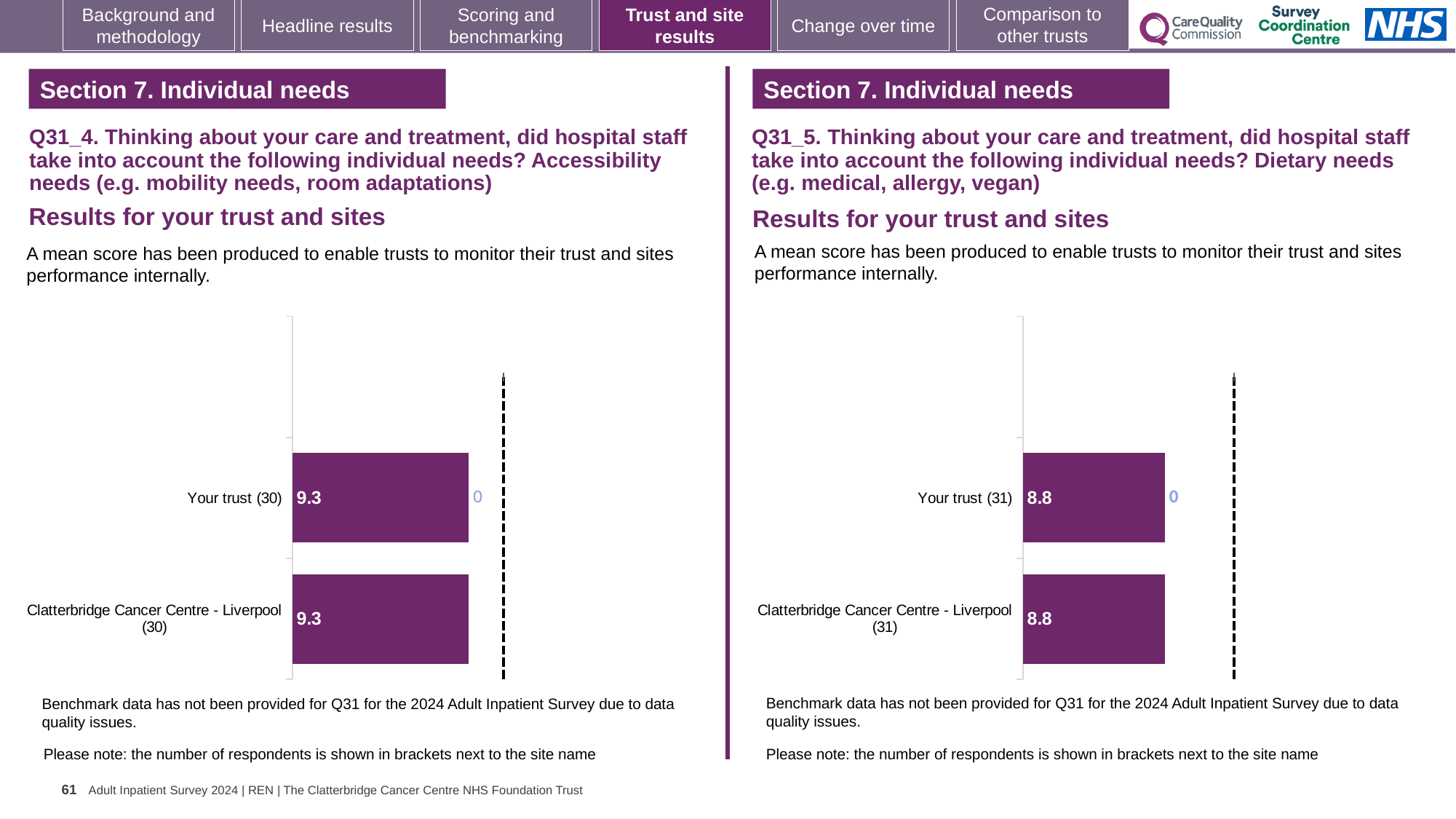
How many bars are plotted on the right chart (Q31_5)? 2 What type of chart is used on the left (Q31_4)? Bar chart How many bars are plotted on the left chart (Q31_4)? 2 On the right chart (Q31_5, Dietary needs), what is the mean score for Clatterbridge Cancer Centre - Liverpool? 8.8 On the left chart (Q31_4, Accessibility needs), what is the mean score for Your trust? 9.3 On the right chart (Q31_5), how many respondents are shown in brackets for Clatterbridge Cancer Centre - Liverpool? 31 Is the Your trust score on the left chart (Q31_4) larger or smaller than the Your trust score on the right chart (Q31_5)? Larger On the right chart (Q31_5), what is the difference between the score for Your trust and the score for Clatterbridge Cancer Centre - Liverpool? 0 On the right chart (Q31_5, Dietary needs), what is the mean score for Your trust? 8.8 On the left chart (Q31_4, Accessibility needs), what is the mean score for Clatterbridge Cancer Centre - Liverpool? 9.3 On the left chart (Q31_4), what is the difference between the score for Your trust and the score for Clatterbridge Cancer Centre - Liverpool? 0 On the left chart (Q31_4), how many respondents are shown in brackets for Your trust? 30